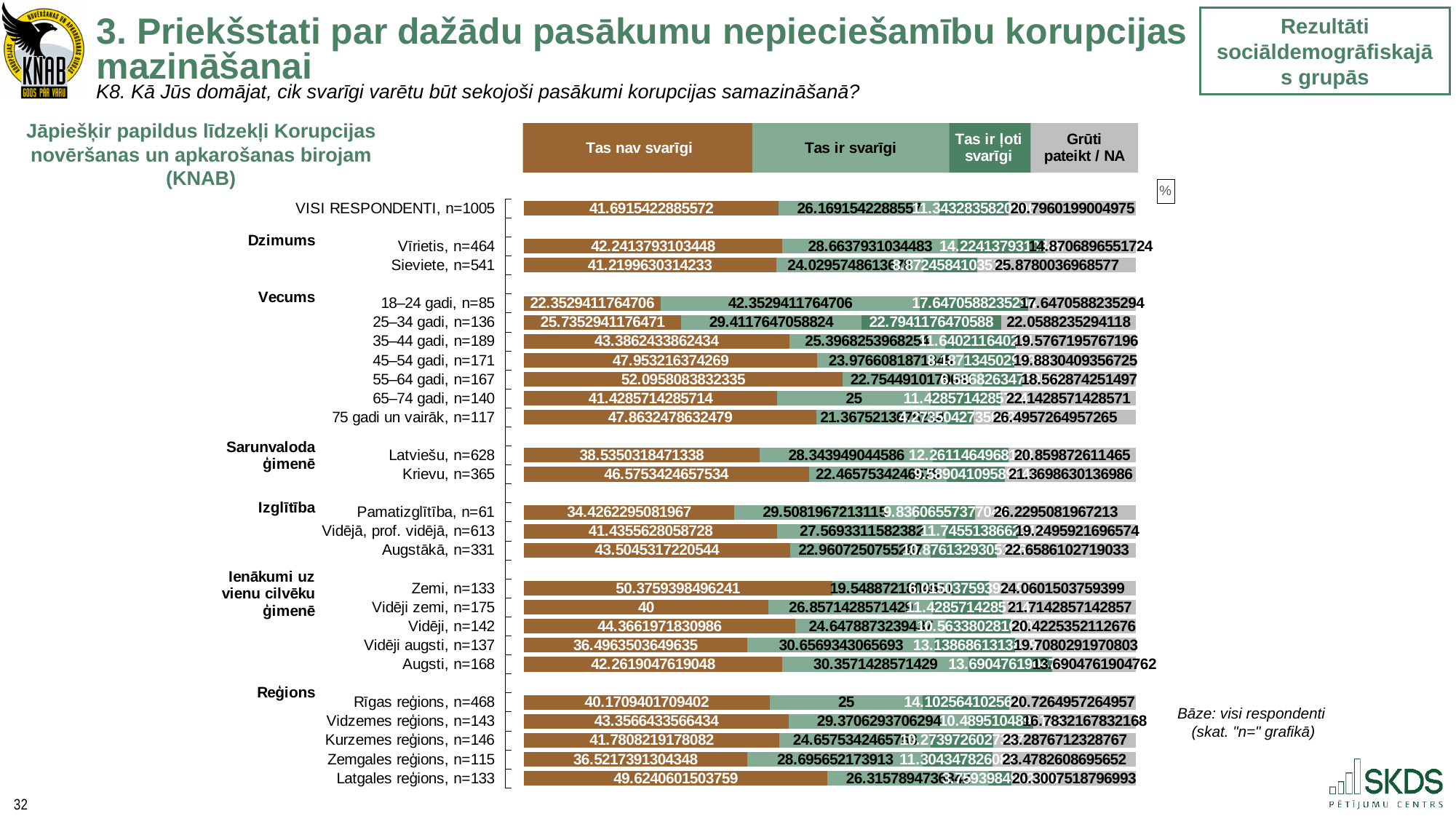
How many regions are listed under Reģions? 5 What is the "Grūti pateikt / NA" value for Sieviete, n=541? 25.8780036968577 For 18–24 gadi, n=85, which is larger: the "Tas nav svarīgi" value or the "Tas ir svarīgi" value? Tas ir svarīgi What is the "Tas ir svarīgi" value for 18–24 gadi, n=85? 42.3529411764706 Among the age groups (Vecums), which has the lowest "Tas nav svarīgi" value? 18–24 gadi, n=85 What is the "Tas ir ļoti svarīgi" value for Rīgas reģions, n=468? 14.1025641025641 Among the age groups (Vecums), which has the highest "Tas nav svarīgi" value? 55–64 gadi, n=167 Among the regions (Reģions), which has the highest "Tas nav svarīgi" value? Latgales reģions, n=133 How many series does the legend list? 4 What is the difference between the "Tas nav svarīgi" values for Zemi, n=133 and Vidēji zemi, n=175? 10.3759398496241 What kind of chart is shown on the slide? Stacked bar chart What is the "Tas nav svarīgi" value for VISI RESPONDENTI, n=1005? 41.6915422885572